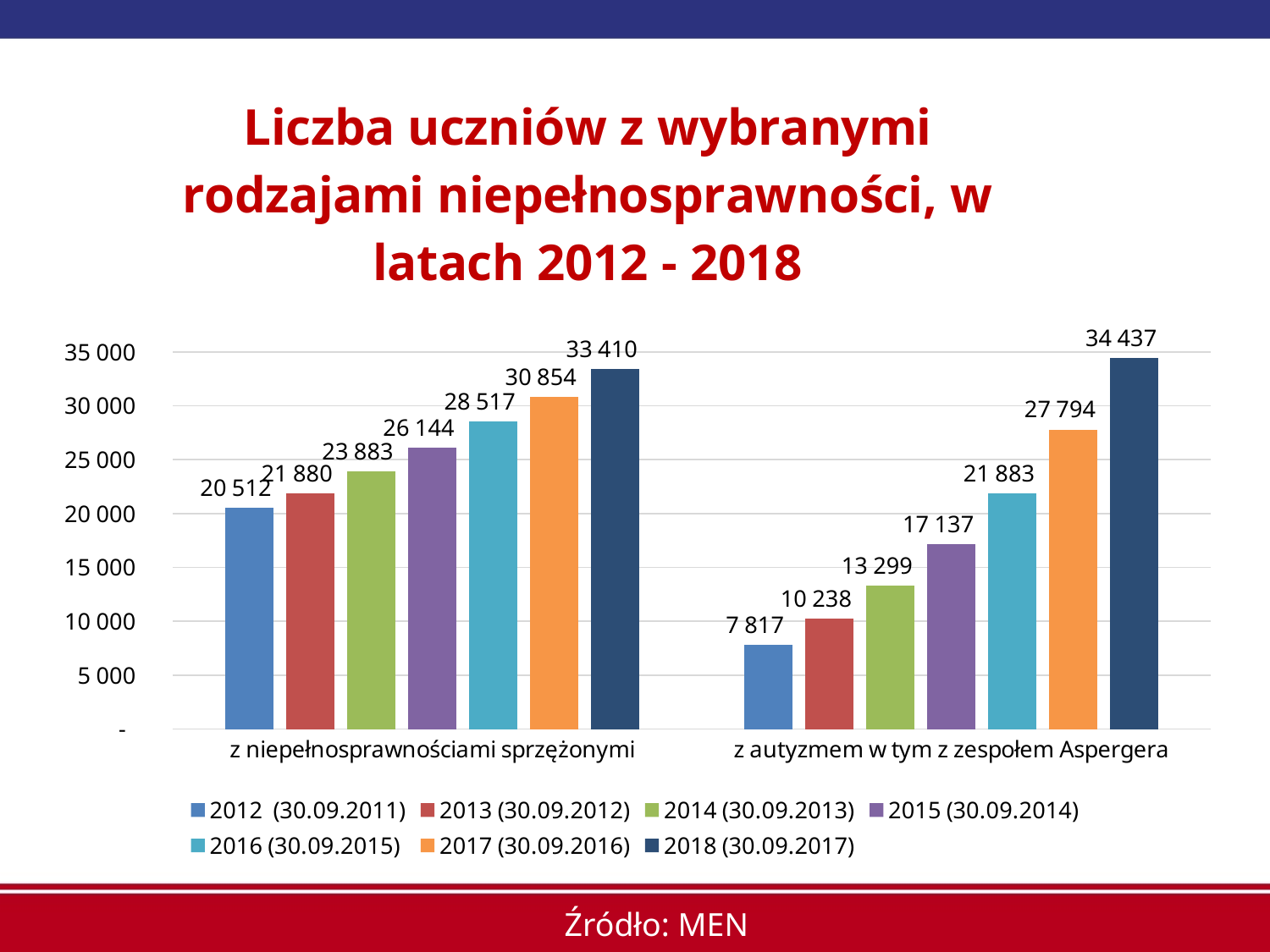
What is the value for 2015 (30.09.2014) in the category 'z autyzmem w tym z zespołem Aspergera'? 17 137 Do the values for 'z autyzmem w tym z zespołem Aspergera' rise or fall from 2012 to 2018? rise What kind of chart is shown on the slide? bar chart Which series has the highest value in the category 'z niepełnosprawnościami sprzężonymi'? 2018 (30.09.2017) How many categories are shown on the x axis? 2 How many series does the legend list? 7 Which is larger: the 2017 (30.09.2016) value for 'z niepełnosprawnościami sprzężonymi' or for 'z autyzmem w tym z zespołem Aspergera'? z niepełnosprawnościami sprzężonymi Is the 2014 (30.09.2013) value for 'z autyzmem w tym z zespołem Aspergera' greater or less than 15 000? less What is the value for 2018 (30.09.2017) in the category 'z autyzmem w tym z zespołem Aspergera'? 34 437 What is the value for 2012 (30.09.2011) in the category 'z niepełnosprawnościami sprzężonymi'? 20 512 What is the difference between the 2018 (30.09.2017) and 2012 (30.09.2011) values in the category 'z autyzmem w tym z zespołem Aspergera'? 26 620 Which series has the lowest value in the category 'z autyzmem w tym z zespołem Aspergera'? 2012 (30.09.2011)